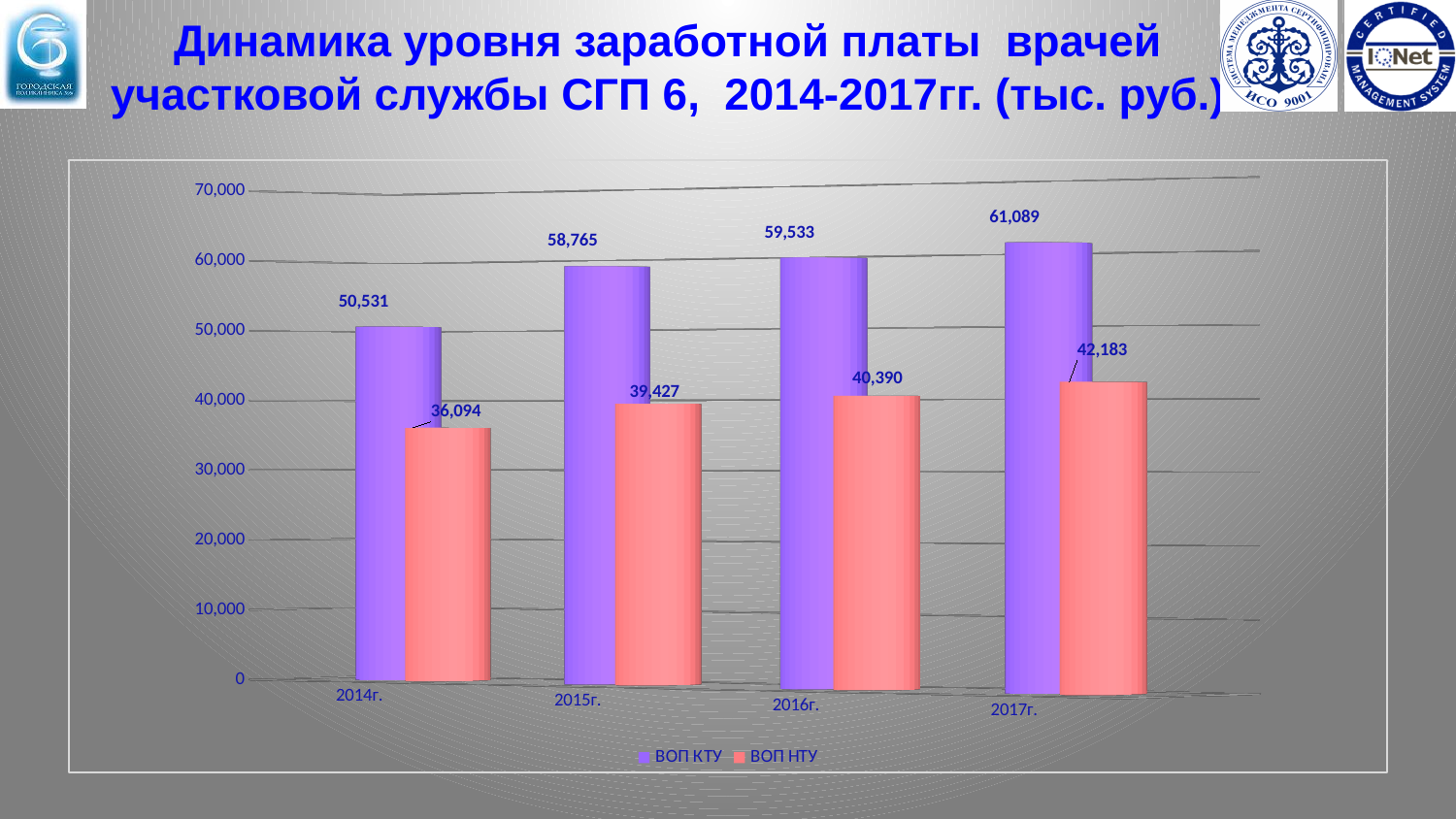
What is the difference between ВОП КТУ and ВОП НТУ in 2017г.? 18,906 Do the ВОП НТУ values rise or fall from 2014г. to 2017г.? rise What is the value for ВОП КТУ in 2017г.? 61,089 By how much did the ВОП КТУ value increase from 2014г. to 2017г.? 10,558 What is the value for ВОП КТУ in 2014г.? 50,531 What is the value for ВОП НТУ in 2016г.? 40,390 In which year is the ВОП НТУ value the lowest? 2014г. Is the value for ВОП НТУ in 2017г. greater or less than 40,000? greater Which is larger in 2015г., ВОП КТУ or ВОП НТУ? ВОП КТУ How many series does the legend list? 2 In which year is the ВОП КТУ value the highest? 2017г. How many years are shown on the x axis? 4